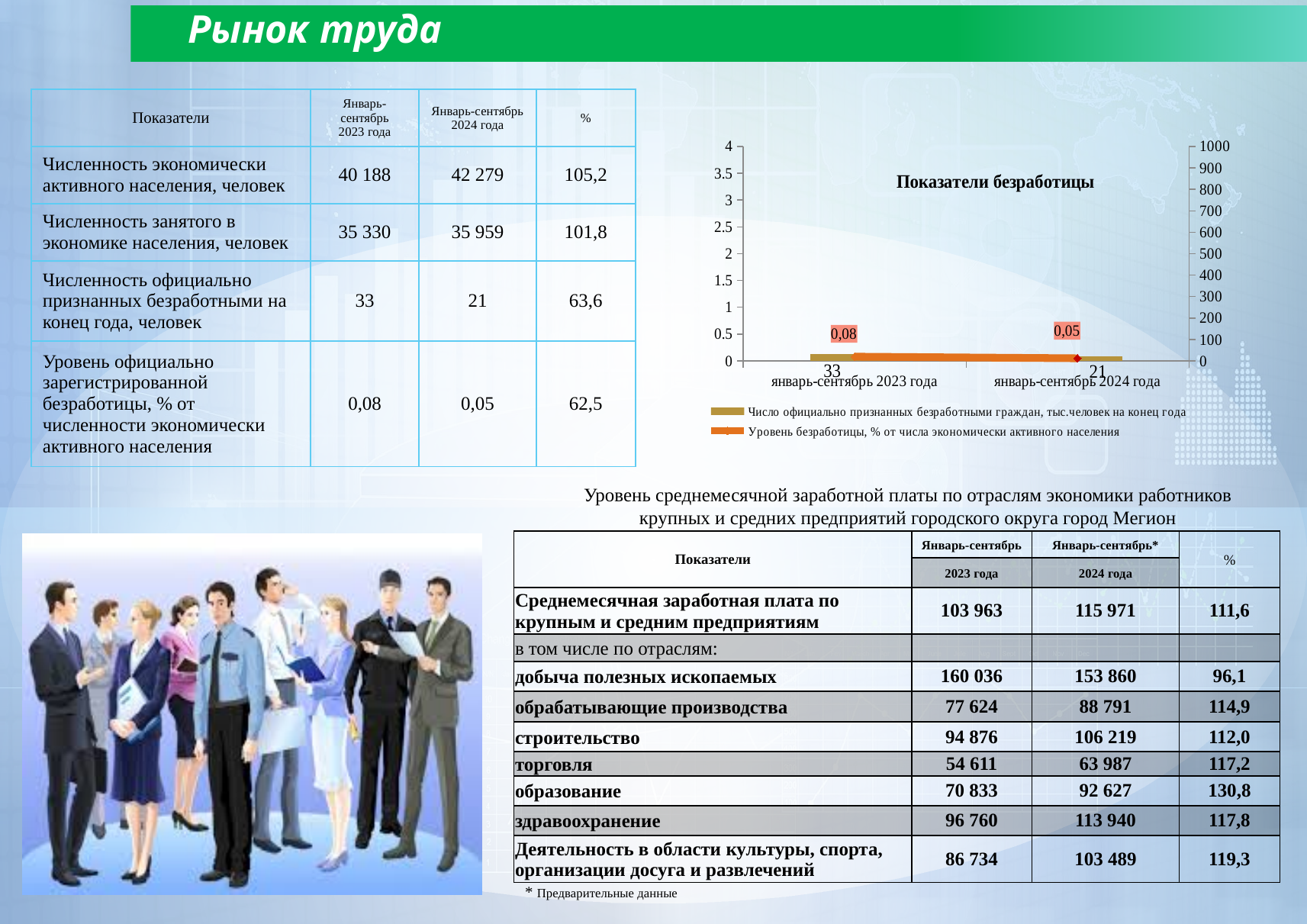
How many periods (categories) are shown on the x axis of the chart "Показатели безработицы"? 2 In the chart "Показатели безработицы", what is the difference between the unemployment rate in январь-сентябрь 2023 года and in январь-сентябрь 2024 года? 0,03 How many series does the legend of the chart "Показатели безработицы" list? 2 In the chart "Показатели безработицы", what is the value of "Уровень безработицы" for январь-сентябрь 2024 года? 0,05 In the chart "Показатели безработицы", what is the value of "Число официально признанных безработными граждан" for январь-сентябрь 2023 года? 33 In the chart "Показатели безработицы", which period has the lower unemployment rate? январь-сентябрь 2024 года In the chart "Показатели безработицы", which period has the higher number of officially recognised unemployed citizens? январь-сентябрь 2023 года In the chart "Показатели безработицы", what is the value of "Уровень безработицы" for январь-сентябрь 2023 года? 0,08 In the chart "Показатели безработицы", does the unemployment rate rise or fall from январь-сентябрь 2023 года to январь-сентябрь 2024 года? fall What is the title of the chart on the slide? Показатели безработицы In the chart "Показатели безработицы", what is the value of "Число официально признанных безработными граждан" for январь-сентябрь 2024 года? 21 In the chart "Показатели безработицы", by how much did the number of officially recognised unemployed citizens fall from январь-сентябрь 2023 года to январь-сентябрь 2024 года? 12